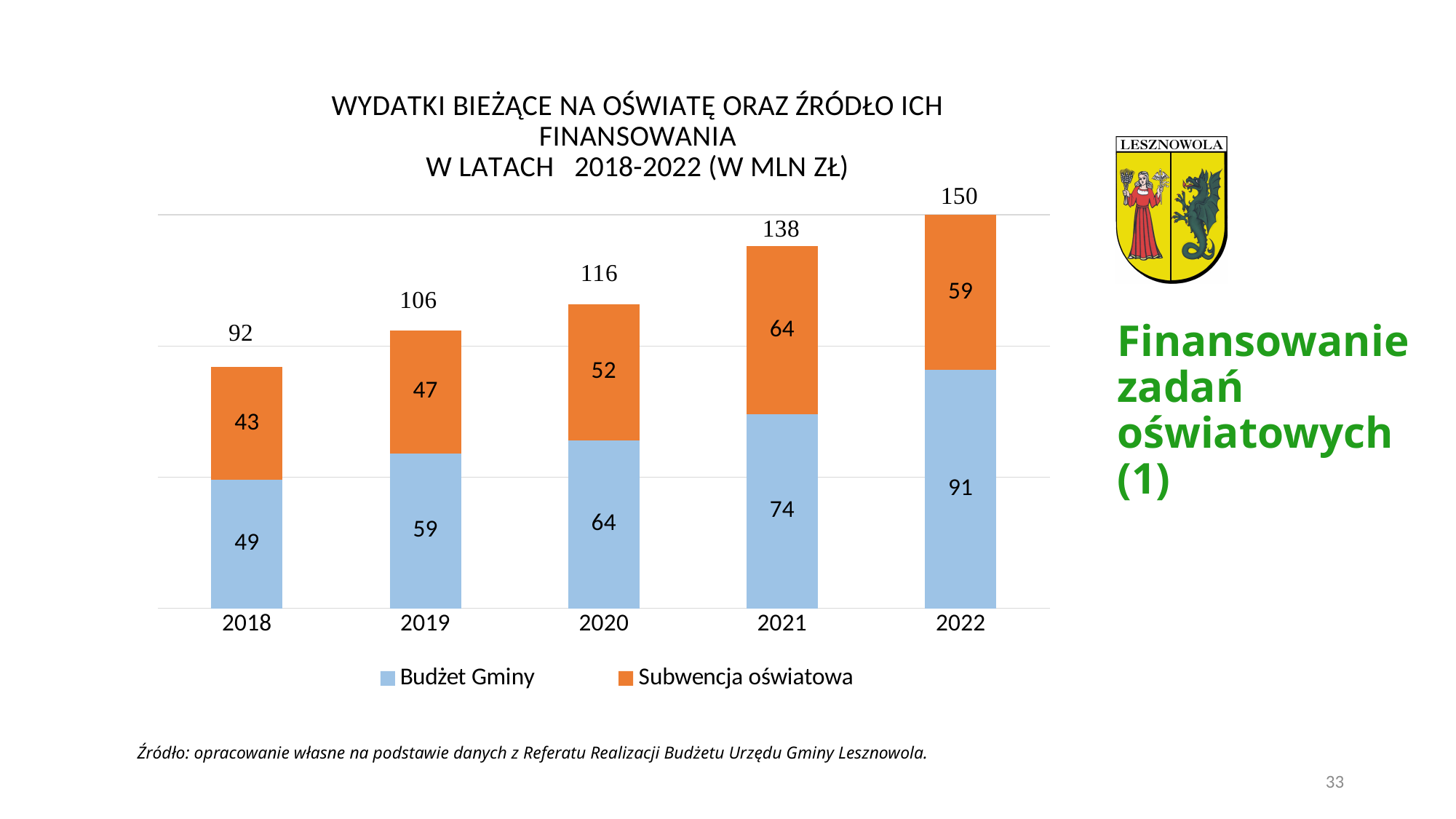
What is the Budżet Gminy value for 2020? 64 How many series does the legend list? 2 Which is larger in 2022: Budżet Gminy or Subwencja oświatowa? Budżet Gminy Which year has the highest total current expenditure on education? 2022 How many years are shown on the x axis? 5 What is the difference between the Budżet Gminy values for 2022 and 2018? 42 What kind of chart is shown on the slide? Stacked bar chart What is the Subwencja oświatowa value for 2021? 64 Which colour represents Subwencja oświatowa in the chart? Orange What is the total shown above the stacked bar for 2019? 106 Do the total values rise or fall from 2018 to 2022? Rise Which year has the lowest Budżet Gminy value? 2018